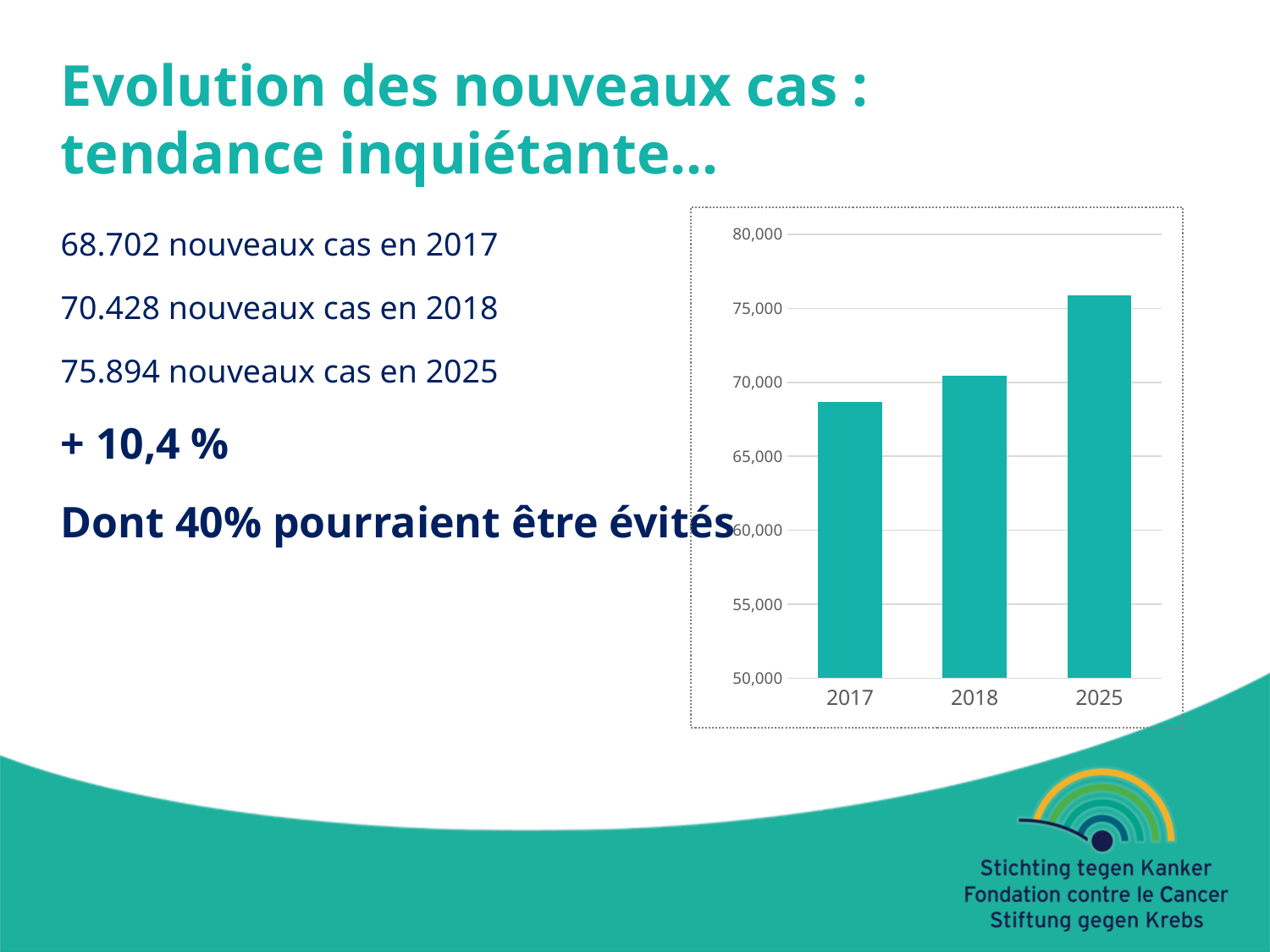
What kind of chart is shown on the slide? bar chart Which year has the lowest bar in the chart? 2017 Which is larger, the value for 2018 or the value for 2025? 2025 Is the value for 2017 greater or less than 70,000? less Do the values rise or fall from 2017 to 2025 along the x axis? rise Is the value for 2025 greater or less than 80,000? less Is the value for 2018 greater or less than 75,000? less What is the lowest value shown on the chart's vertical axis? 50,000 How many bars does the chart show? 3 Which year has the highest bar in the chart? 2025